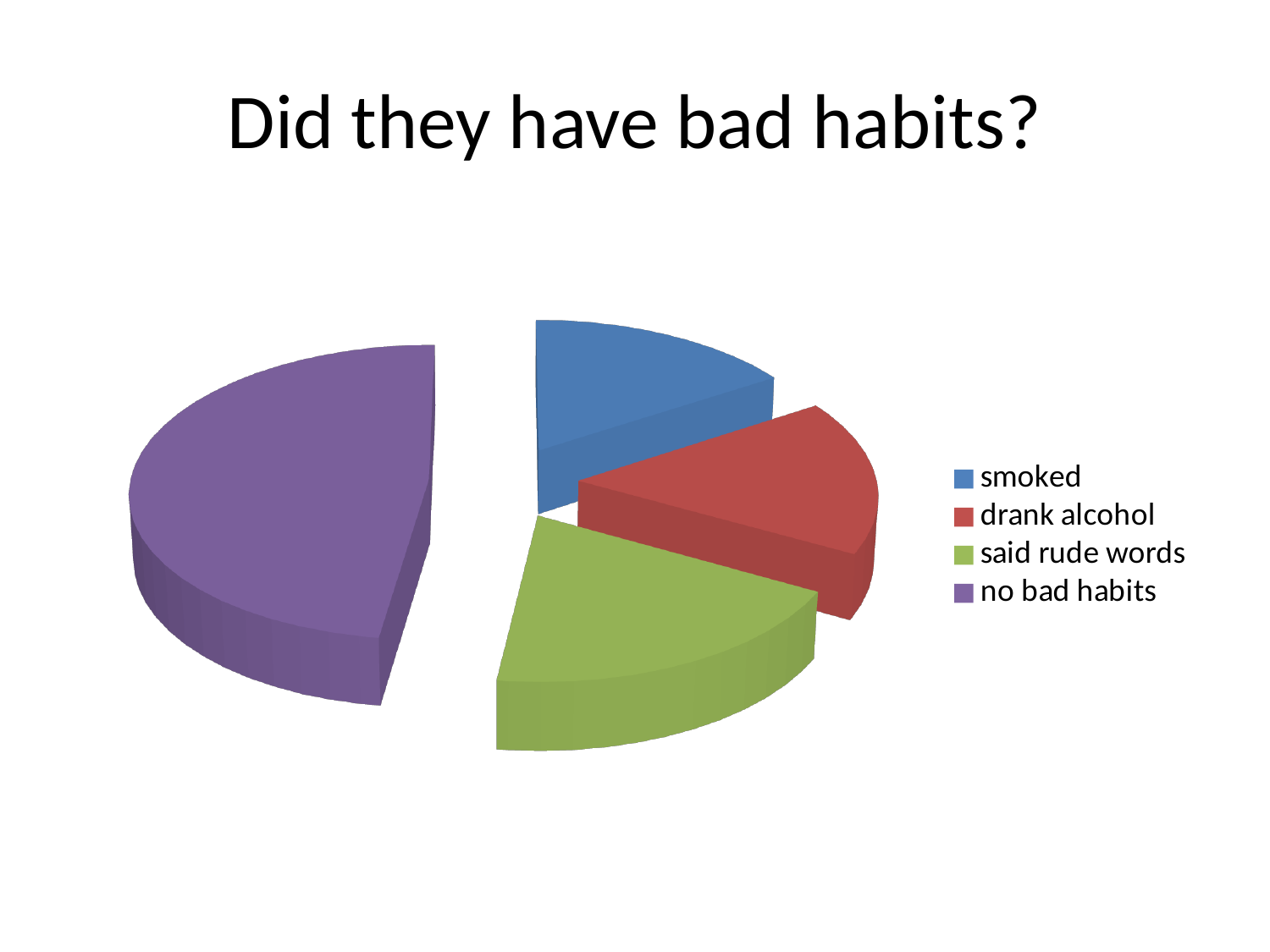
Which slice is larger: no bad habits or said rude words? no bad habits Which colour represents the 'drank alcohol' category? red What kind of chart is shown on the slide? pie chart Which slice is larger: said rude words or smoked? said rude words What is the title of the chart? Did they have bad habits? How many entries does the legend list? 4 How many categories does the pie chart show? 4 Which category has the largest slice of the pie? no bad habits Which slice is larger: no bad habits or drank alcohol? no bad habits